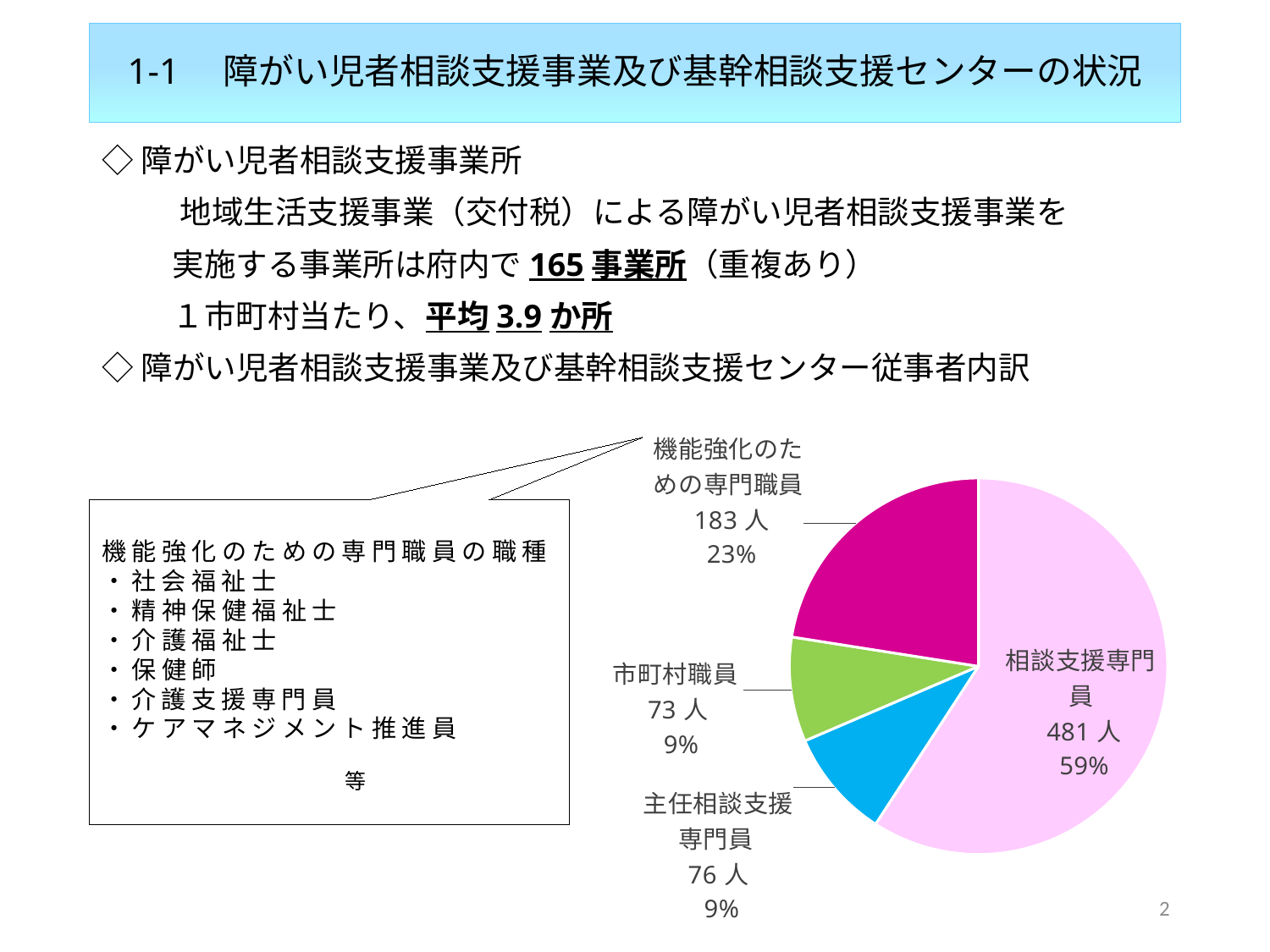
Which category has the largest slice in the pie chart? 相談支援専門員 How many people are in the 相談支援専門員 slice of the pie chart? 481 人 What share of the pie does 機能強化のための専門職員 represent? 23% What share of the pie does 相談支援専門員 represent? 59% How many people are in the 市町村職員 slice of the pie chart? 73 人 Which category has the smallest number of people in the pie chart? 市町村職員 How many people are in the 機能強化のための専門職員 slice of the pie chart? 183 人 How many slices does the pie chart have? 4 What kind of chart is shown on the slide? pie chart Which has more people, 市町村職員 or 主任相談支援専門員? 主任相談支援専門員 What is the difference in people between 相談支援専門員 and 機能強化のための専門職員? 298 人 How many people are in the 主任相談支援専門員 slice of the pie chart? 76 人